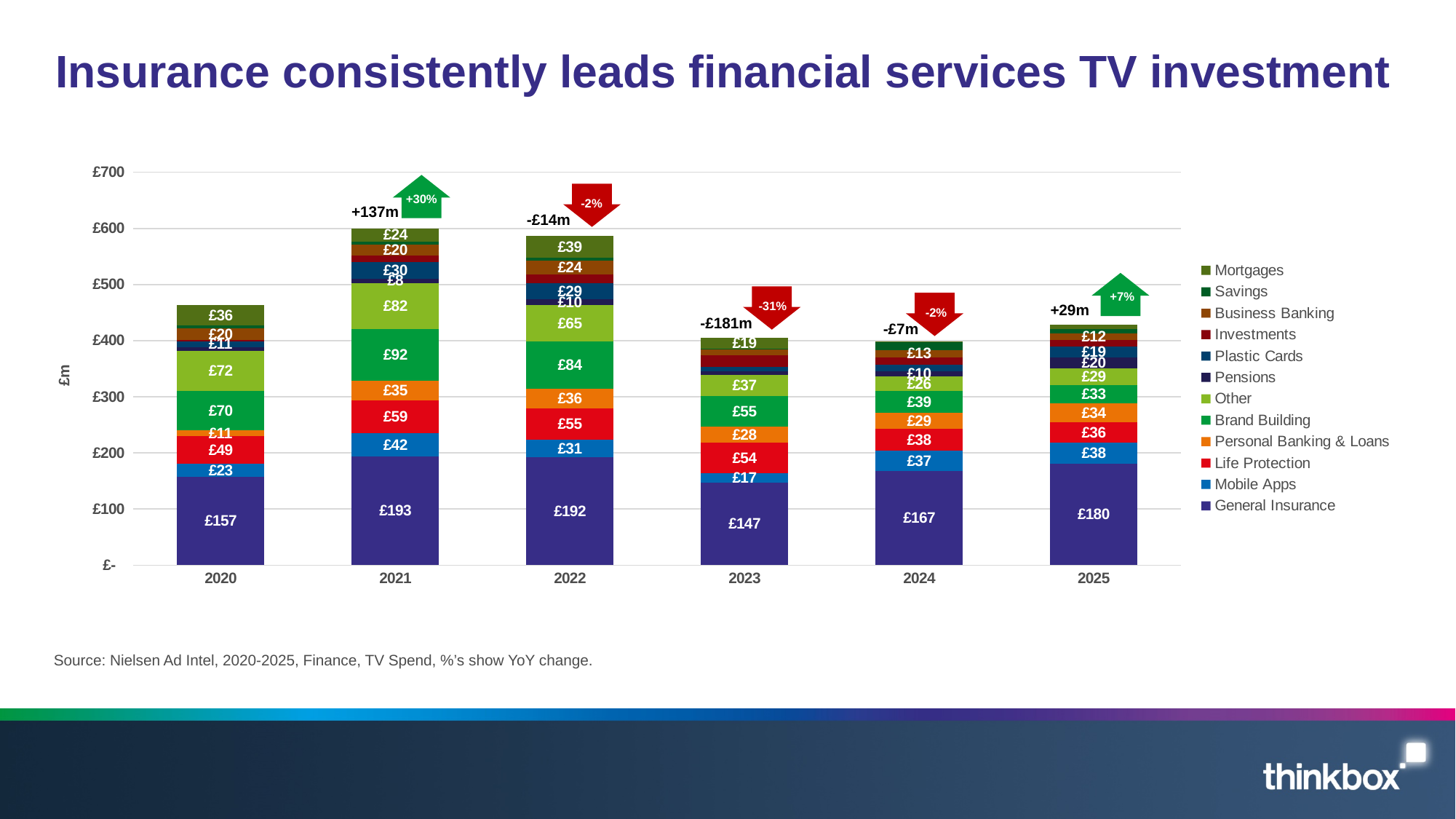
How many years are shown on the x axis? 6 What is the Mobile Apps value for 2024? £37 What is the difference between the General Insurance values for 2025 and 2023? £33 What year-on-year percentage change is shown above the 2023 bar? -31% In which year is the Brand Building segment highest? 2021 Which is larger, the Life Protection value for 2021 or for 2024? 2021 In which year is the General Insurance segment lowest? 2023 Is the total height of the 2023 bar greater or less than £500? less What kind of chart is shown on the slide? Stacked bar chart What is the General Insurance value for 2020? £157 What is the Brand Building value for 2022? £84 How many series does the legend list? 12